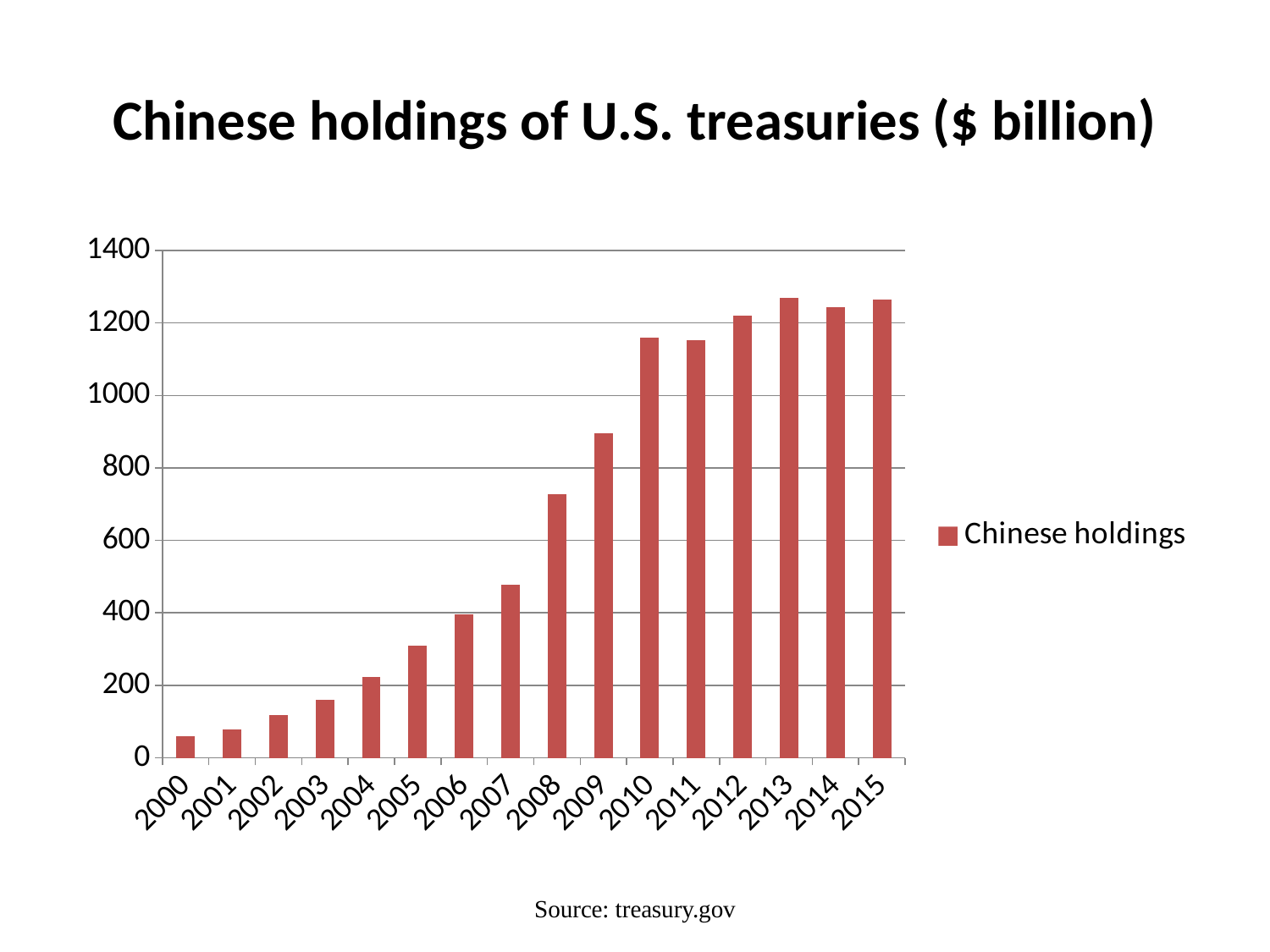
How many years are shown on the x axis of the chart? 16 Is the value for 2009 greater or less than 800? greater Is the value for 2008 greater or less than 800? less Is the value for 2010 greater or less than 1000? greater What is the name of the series shown in the legend? Chinese holdings Do Chinese holdings of U.S. treasuries generally rise or fall from 2000 to 2015? rise Which year has the larger value, 2008 or 2009? 2009 What kind of chart is shown on the slide? bar chart Which year has the lowest Chinese holdings of U.S. treasuries? 2000 How many series does the legend list? 1